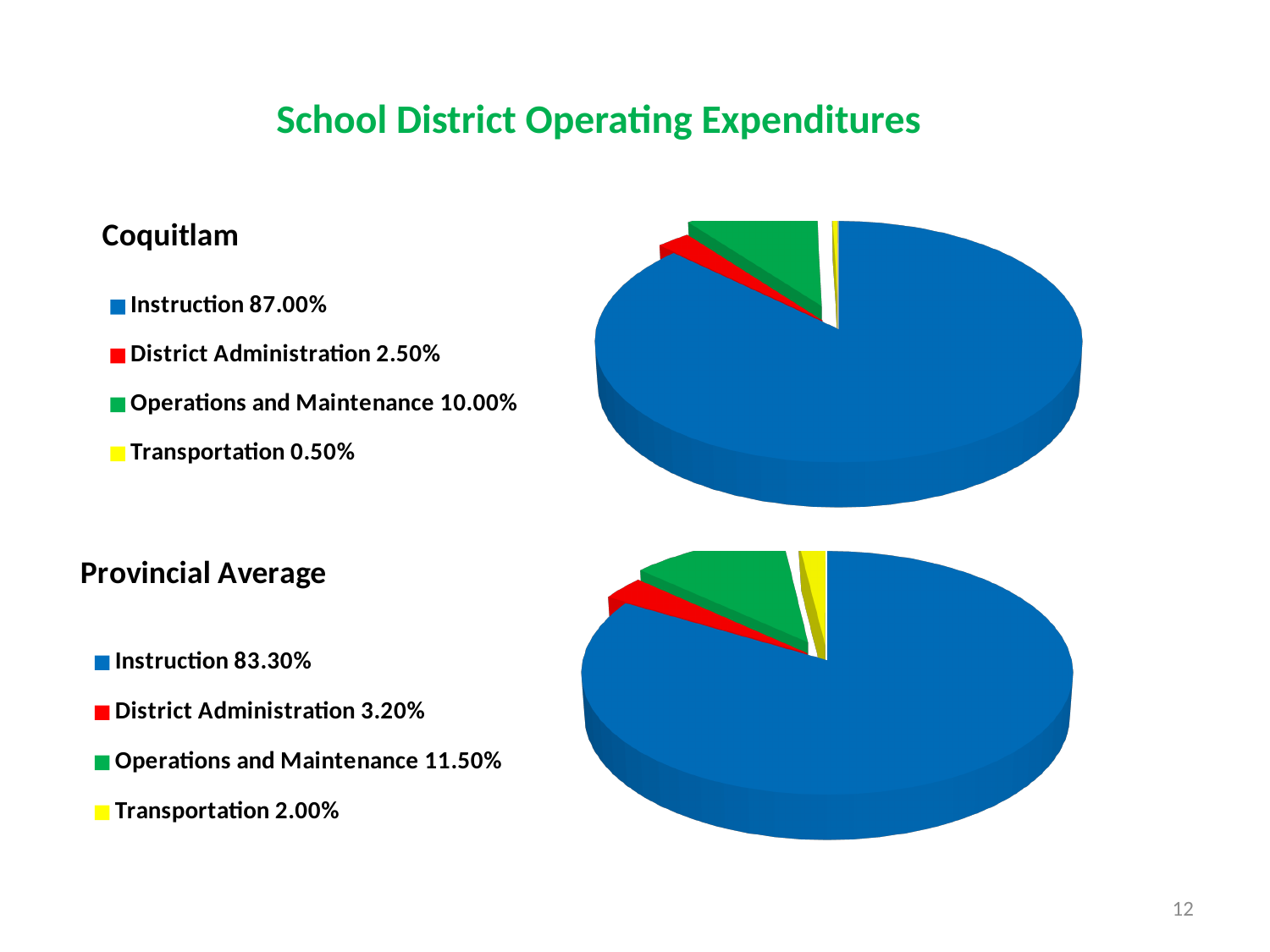
Is the Transportation share larger in the Coquitlam chart or the Provincial Average chart? Provincial Average What colour represents Operations and Maintenance in both pie charts? Green In the Coquitlam pie chart, what is the difference between Operations and Maintenance and District Administration? 7.50% In the Provincial Average pie chart, what share is District Administration? 3.20% In the Coquitlam pie chart, what share is Instruction? 87.00% In the Provincial Average pie chart, which category has the smallest share? Transportation What type of chart is used for the Provincial Average data? Pie chart In the Coquitlam pie chart, what share is Transportation? 0.50% What is the difference between the Instruction share in the Coquitlam chart and the Instruction share in the Provincial Average chart? 3.70% In the Coquitlam pie chart, which category has the largest share? Instruction How many categories does the Coquitlam pie chart show? 4 In the Provincial Average pie chart, what share is Operations and Maintenance? 11.50%